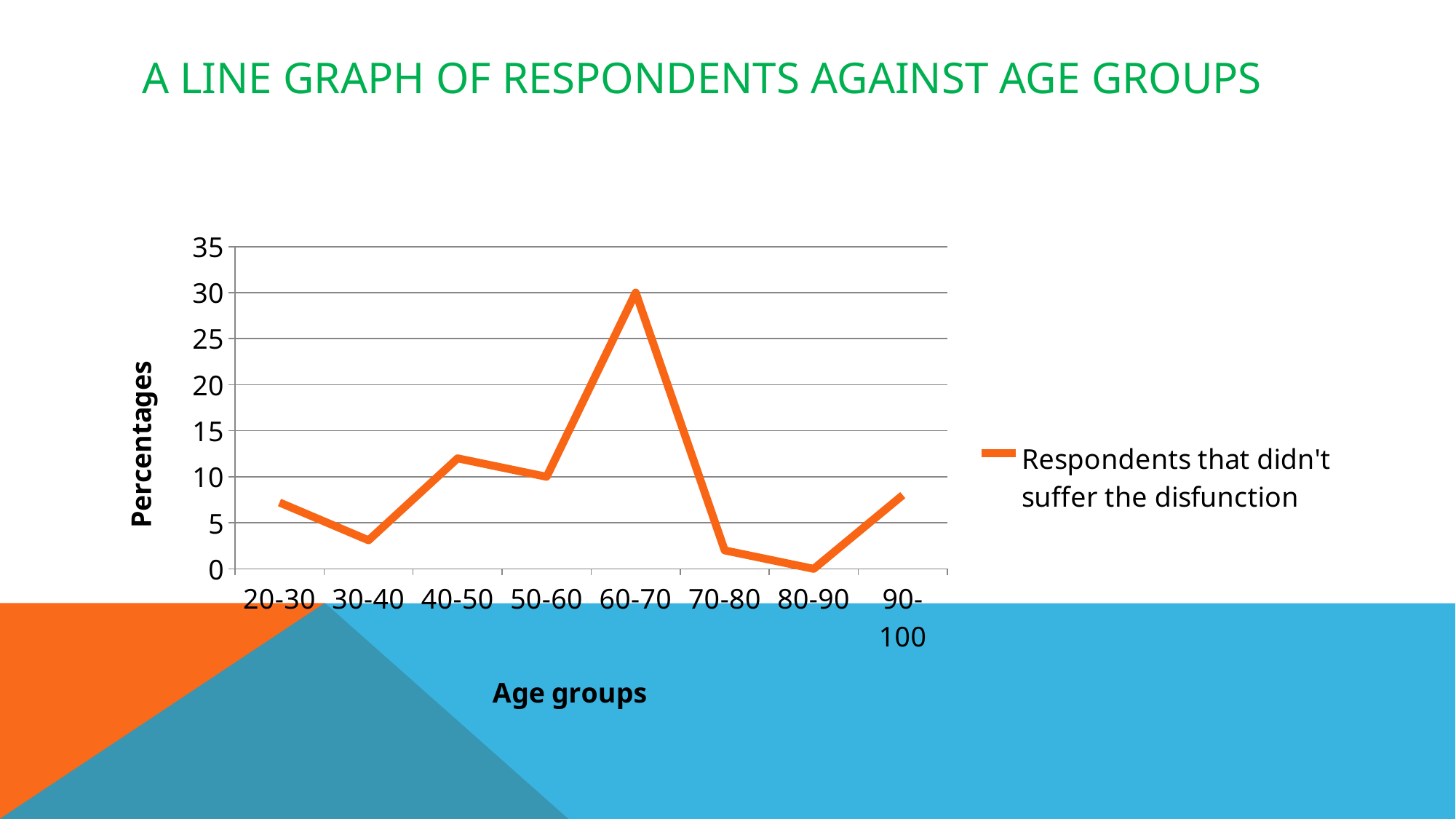
What is the percentage for the 60-70 age group? 30 Which has a higher percentage, the 40-50 age group or the 30-40 age group? 40-50 Is the value for the 30-40 age group greater or less than 5? less Which age group has the lowest percentage? 80-90 Is the value for the 20-30 age group greater or less than 5? greater What is the percentage for the 80-90 age group? 0 What kind of chart is shown on the slide? line chart Which age group has the highest percentage? 60-70 Do the values rise or fall from the 60-70 age group to the 80-90 age group? fall Is the value for the 70-80 age group greater or less than 5? less How many series does the legend list? 1 How many age groups are plotted on the x axis? 8